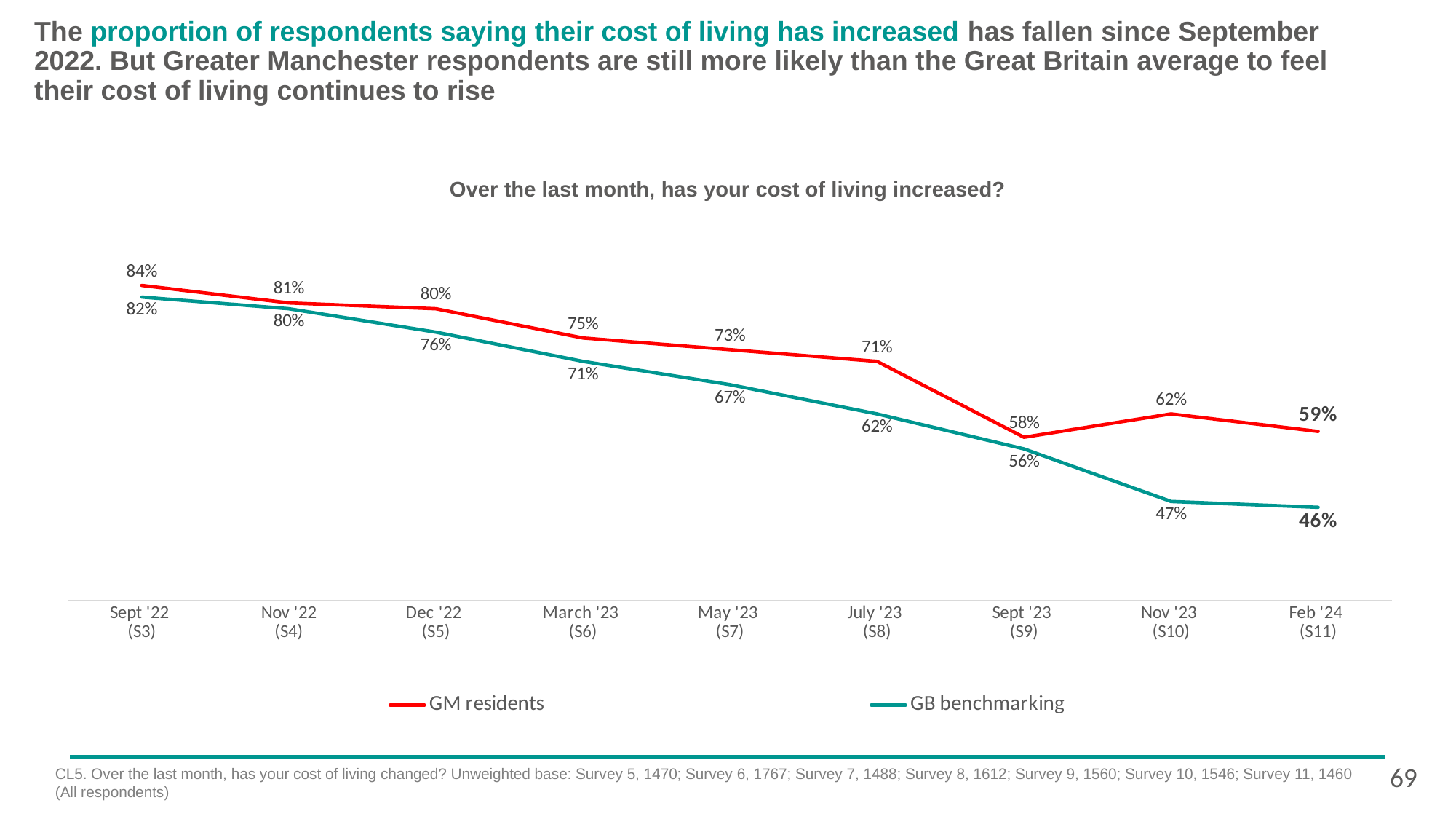
Does the GB benchmarking series rise or fall from Sept '22 to Feb '24? Fall How many survey waves are plotted on the x axis? 9 What is the value for GB benchmarking in Feb '24 (S11)? 46% Which series has the higher value in Sept '23 (S9), GM residents or GB benchmarking? GM residents What is the difference between GM residents and GB benchmarking in Feb '24 (S11)? 13 percentage points What kind of chart is shown on the slide? Line chart How many series does the legend list? 2 What is the value for GB benchmarking in July '23 (S8)? 62% In which survey wave is the GB benchmarking value highest? Sept '22 (S3) What is the value for GM residents in Sept '22 (S3)? 84% What is the value for GM residents in Nov '23 (S10)? 62% In which survey wave is the GM residents value lowest? Sept '23 (S9)